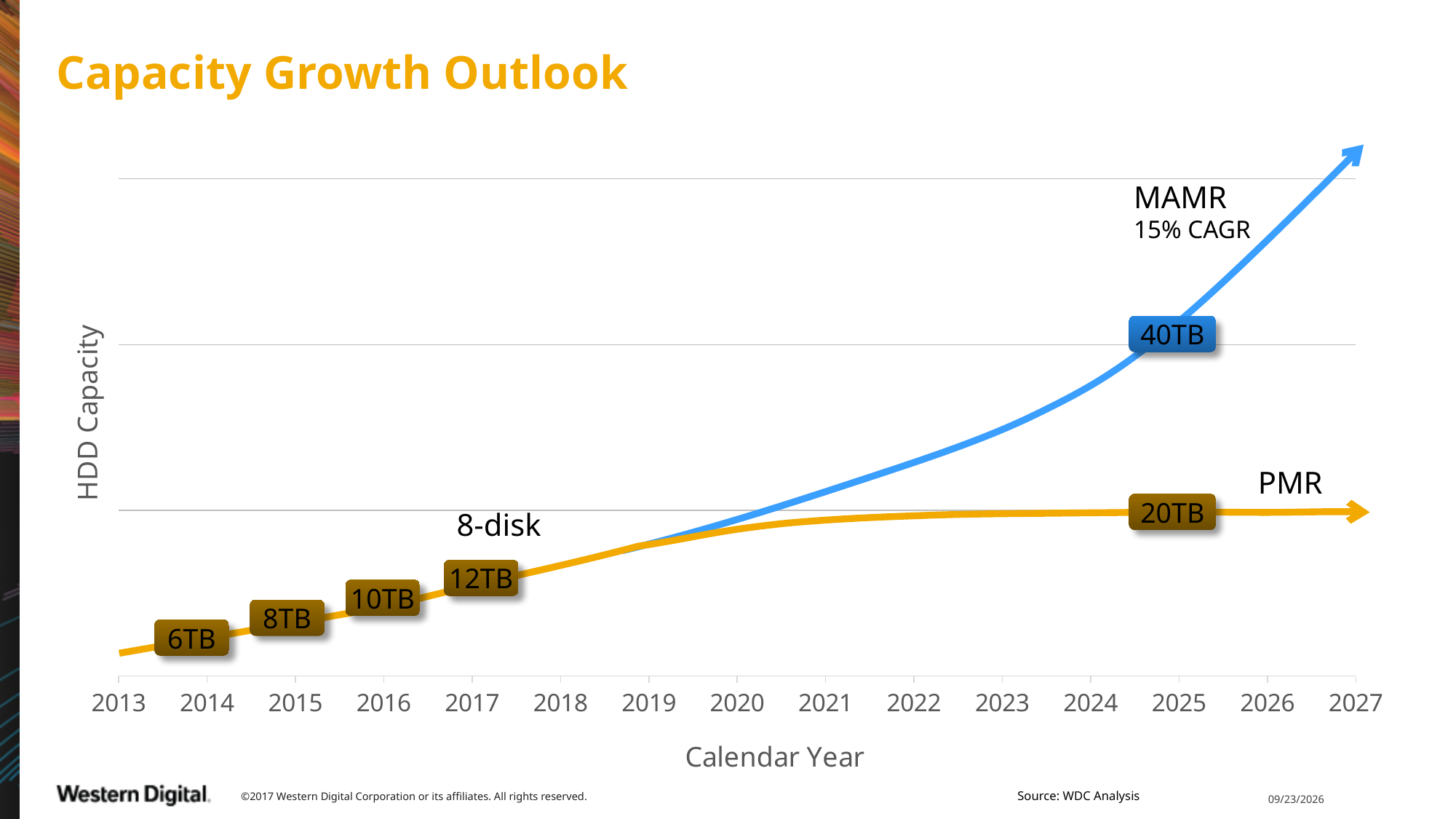
What CAGR is stated for the MAMR line? 15% CAGR What is the label on the x axis of the chart? Calendar Year What capacity is labelled on the MAMR line around 2025? 40TB What is the lowest capacity label shown on the PMR line? 6TB What capacity is labelled on the PMR line around 2025? 20TB Around 2025, which line shows the higher capacity, MAMR or PMR? MAMR Does the MAMR line rise or fall from 2019 to 2027? rise What is the difference between the MAMR and PMR capacity labels around 2025? 20TB What kind of chart is shown on the slide? line chart How many years are labelled on the x axis? 15 What is the title of the chart? Capacity Growth Outlook How many lines (series) are plotted on the chart? 2